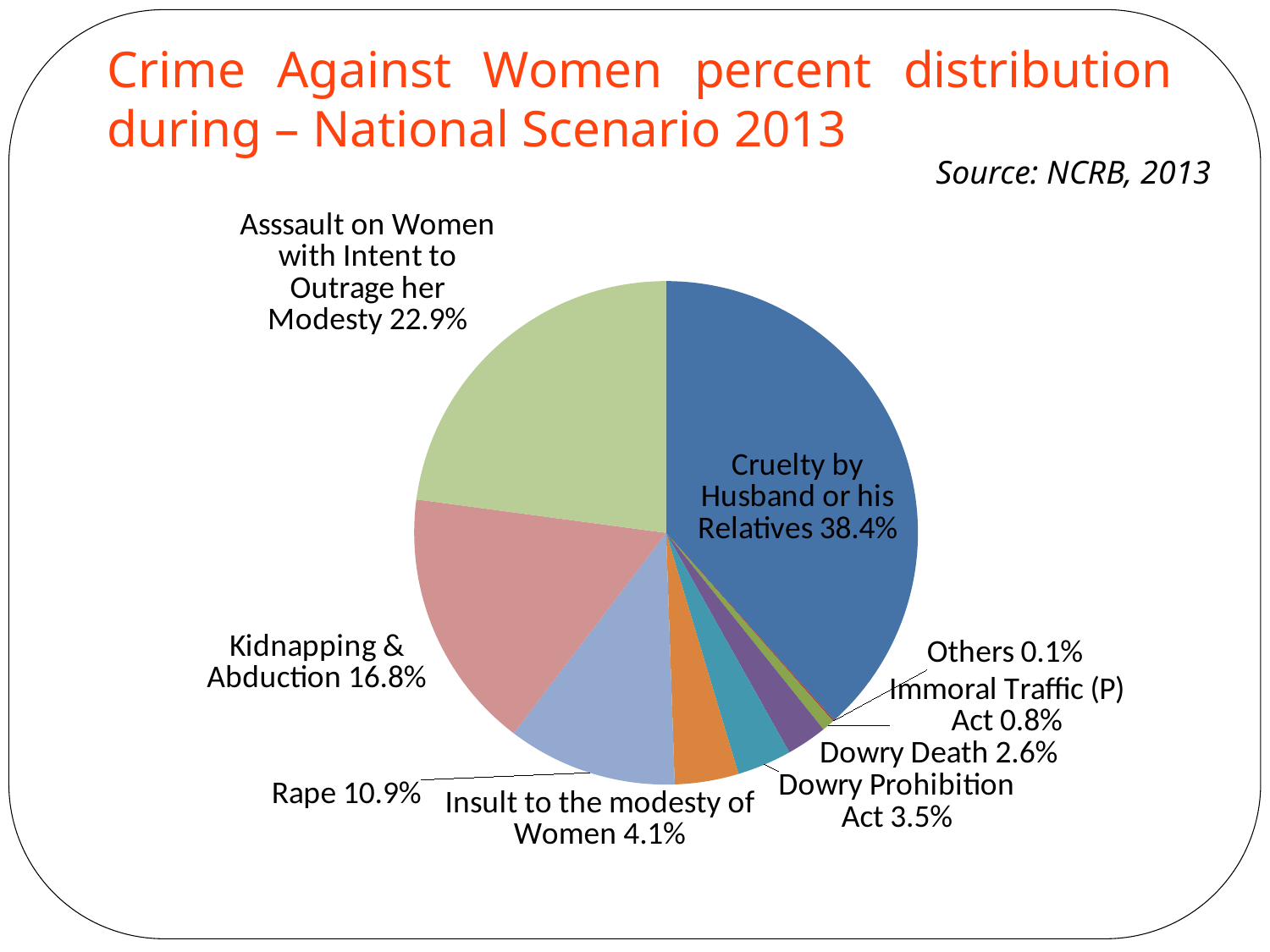
What is the percentage for Kidnapping & Abduction? 16.8% What share of the pie does Rape account for? 10.9% What is the difference in percentage points between Cruelty by Husband or his Relatives and Assault on Women with Intent to Outrage her Modesty? 15.5 Which category has the smallest share of the pie? Others Which category has the largest share of the pie? Cruelty by Husband or his Relatives Which is larger, the share for Dowry Prohibition Act or the share for Dowry Death? Dowry Prohibition Act What source is cited for the data on the slide? NCRB, 2013 How many categories (slices) are shown in the pie chart? 9 What kind of chart is shown on the slide? Pie chart What percentage of crimes against women is attributed to Cruelty by Husband or his Relatives? 38.4% What is the difference in percentage points between Kidnapping & Abduction and Rape? 5.9 What is the percentage shown for Dowry Death? 2.6%